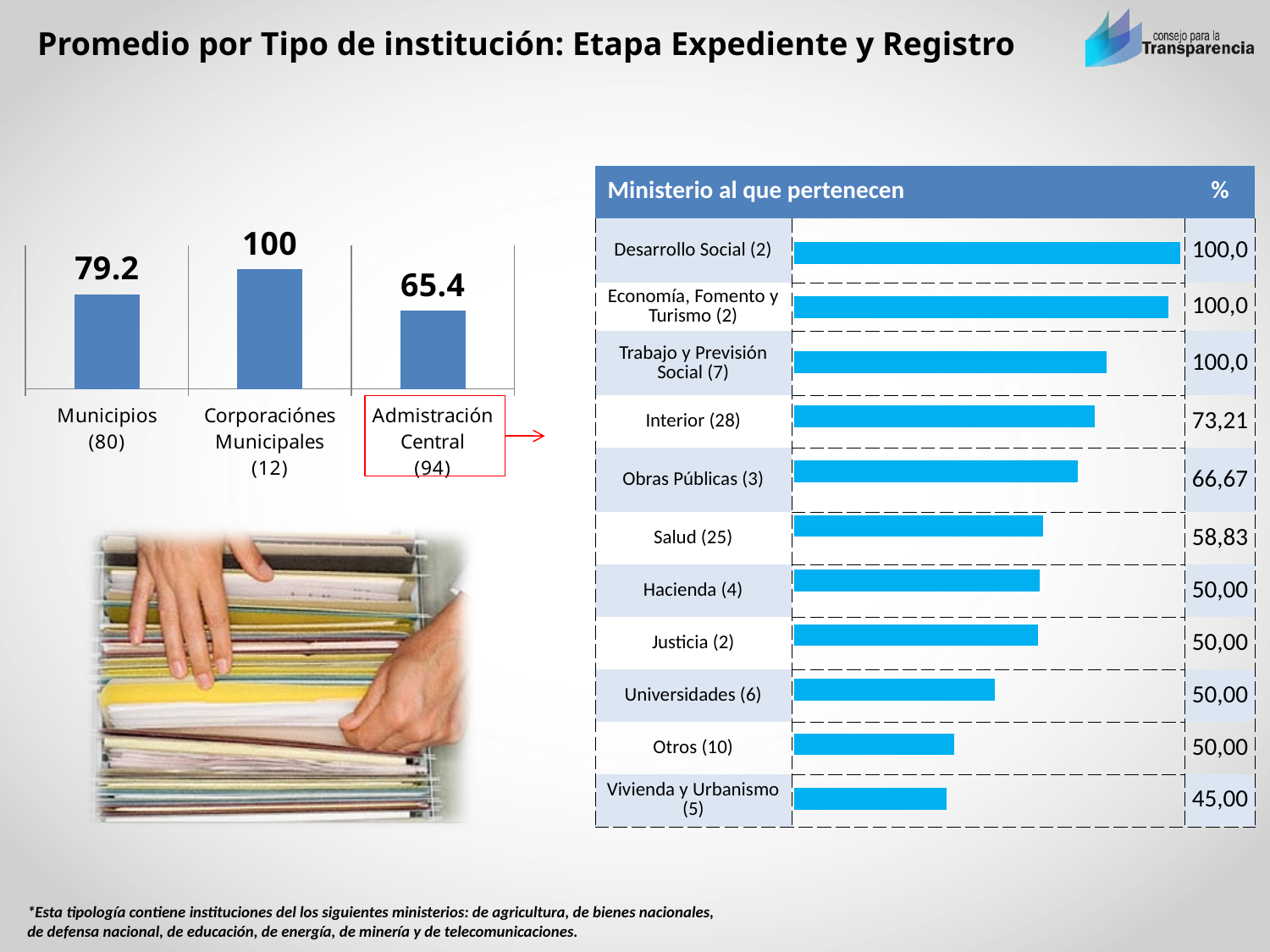
In the left bar chart, what is the value for Admistración Central (94)? 65.4 In the left bar chart, what is the value for Municipios (80)? 79.2 In the right chart titled 'Ministerio al que pertenecen', which ministry has the lowest percentage? Vivienda y Urbanismo (5) In the left bar chart, what is the value for Corporaciones Municipales (12)? 100 In the right chart titled 'Ministerio al que pertenecen', what is the percentage for Salud (25)? 58,83 In the right chart titled 'Ministerio al que pertenecen', how many ministries are listed? 11 In the left bar chart, which category has the highest value? Corporaciones Municipales (12) In the right chart titled 'Ministerio al que pertenecen', what is the percentage for Interior (28)? 73,21 In the left bar chart, what is the difference between the values for Municipios (80) and Admistración Central (94)? 13.8 In the left bar chart, which category has the lowest value? Admistración Central (94) In the left bar chart, how many categories are shown? 3 What kind of chart is the left chart? Bar chart